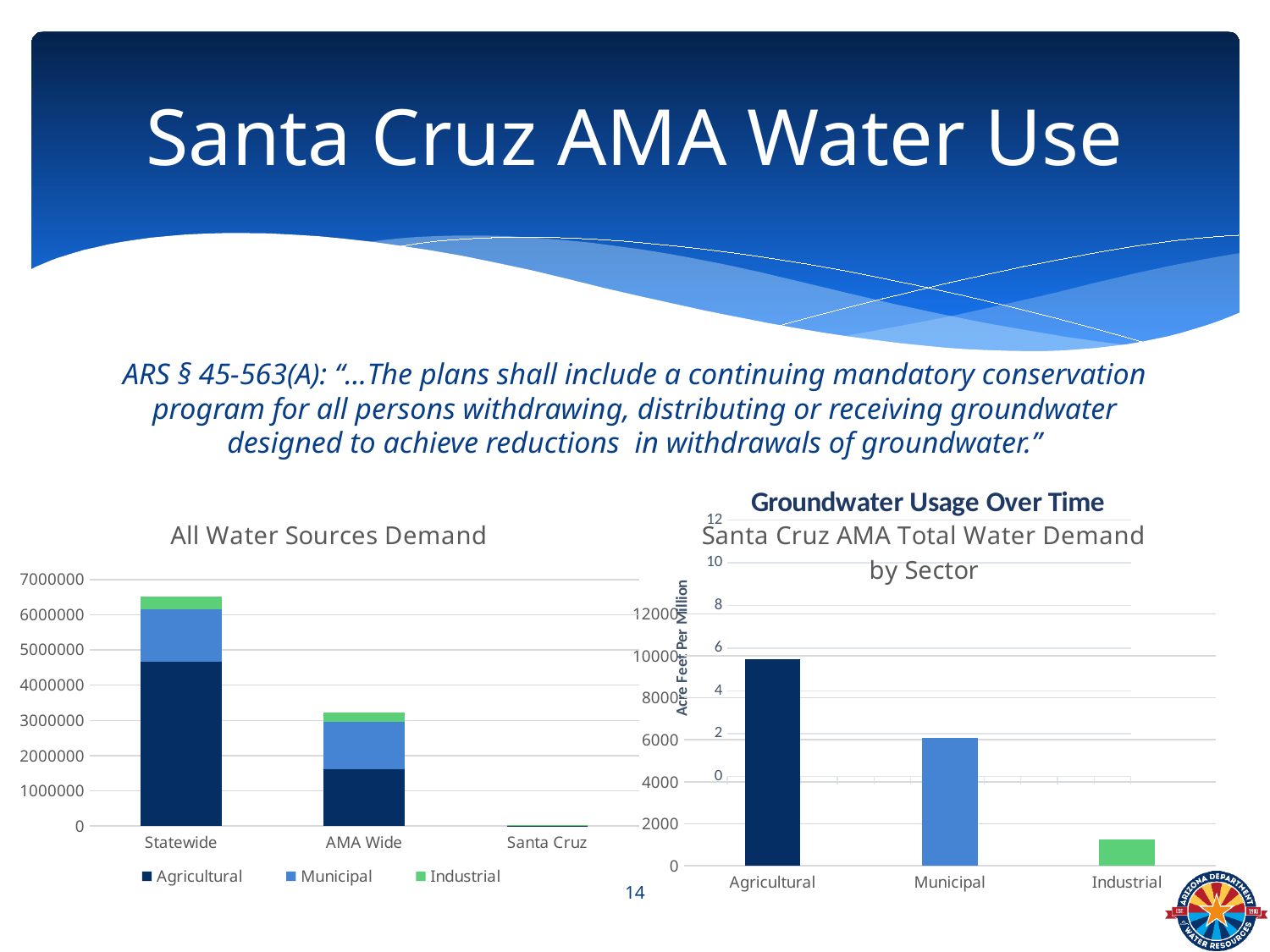
In the 'All Water Sources Demand' chart, is the total stacked bar for AMA Wide greater or less than 4000000? less In the 'Santa Cruz AMA Total Water Demand by Sector' chart, which sector has the lowest demand? Industrial In the 'Santa Cruz AMA Total Water Demand by Sector' chart, is the value for Industrial greater or less than 2000? less In the 'Santa Cruz AMA Total Water Demand by Sector' chart, is the value for Agricultural greater or less than 8000? greater In the 'All Water Sources Demand' chart, which category has the smallest stacked bar? Santa Cruz In the 'All Water Sources Demand' chart, which category has the tallest stacked bar? Statewide In the 'Santa Cruz AMA Total Water Demand by Sector' chart, which is larger, Municipal or Industrial? Municipal How many series does the legend of the 'All Water Sources Demand' chart list? 3 What kind of chart is the 'All Water Sources Demand' chart? Stacked bar chart In the 'Santa Cruz AMA Total Water Demand by Sector' chart, which sector has the highest demand? Agricultural How many categories are shown on the x axis of the 'All Water Sources Demand' chart? 3